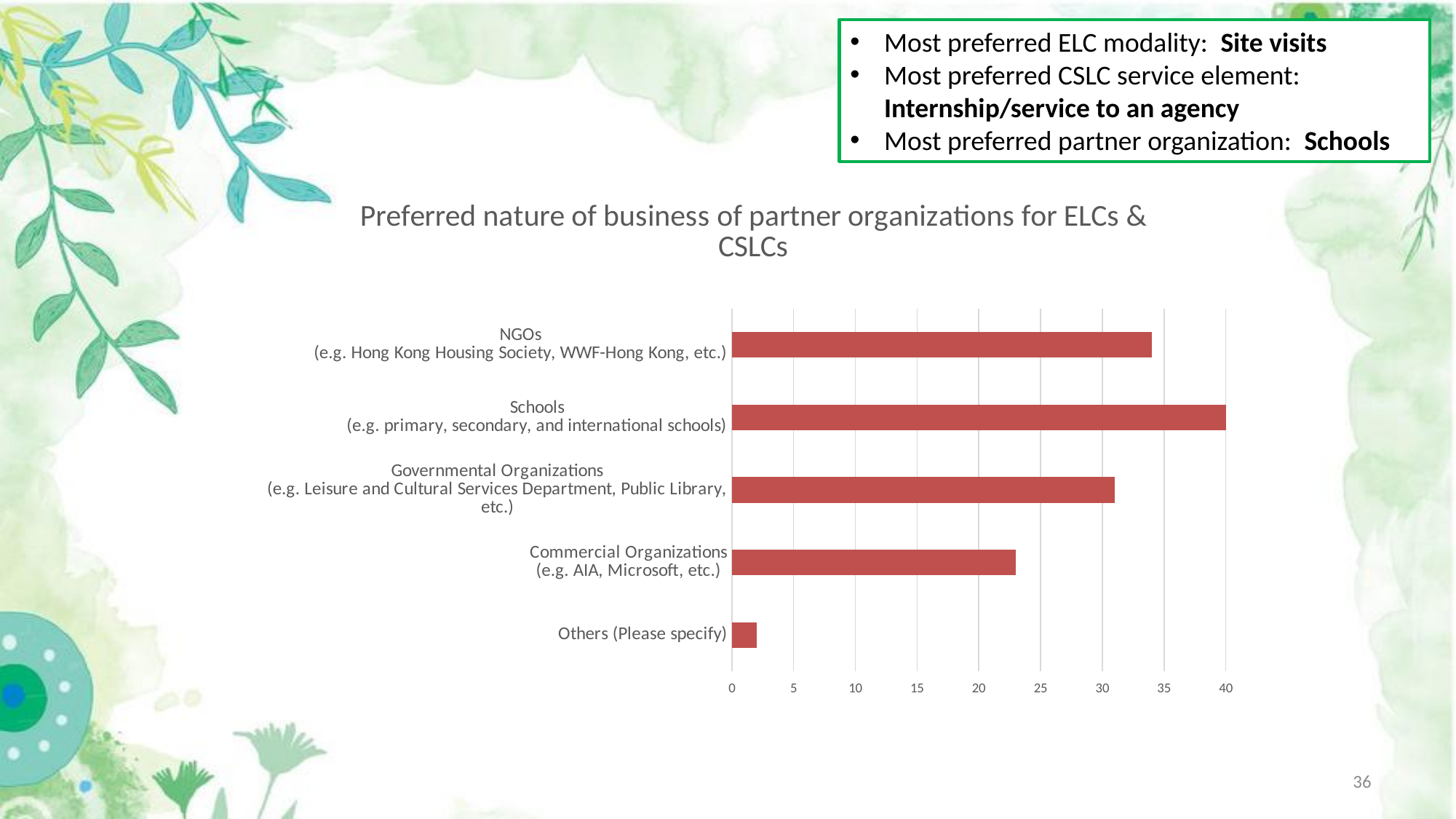
What is the value for Schools? 40 How many categories are plotted in the chart? 5 Which is larger, the value for NGOs or the value for Commercial Organizations? NGOs Which category has the lowest value? Others (Please specify) Which is larger, the value for Governmental Organizations or the value for Schools? Schools Is the value for Governmental Organizations greater or less than 35? less Is the value for Others (Please specify) greater or less than 5? less What is the title of the chart? Preferred nature of business of partner organizations for ELCs & CSLCs Is the value for Commercial Organizations greater or less than 25? less What kind of chart is shown on the slide? Bar chart Which category has the highest value? Schools